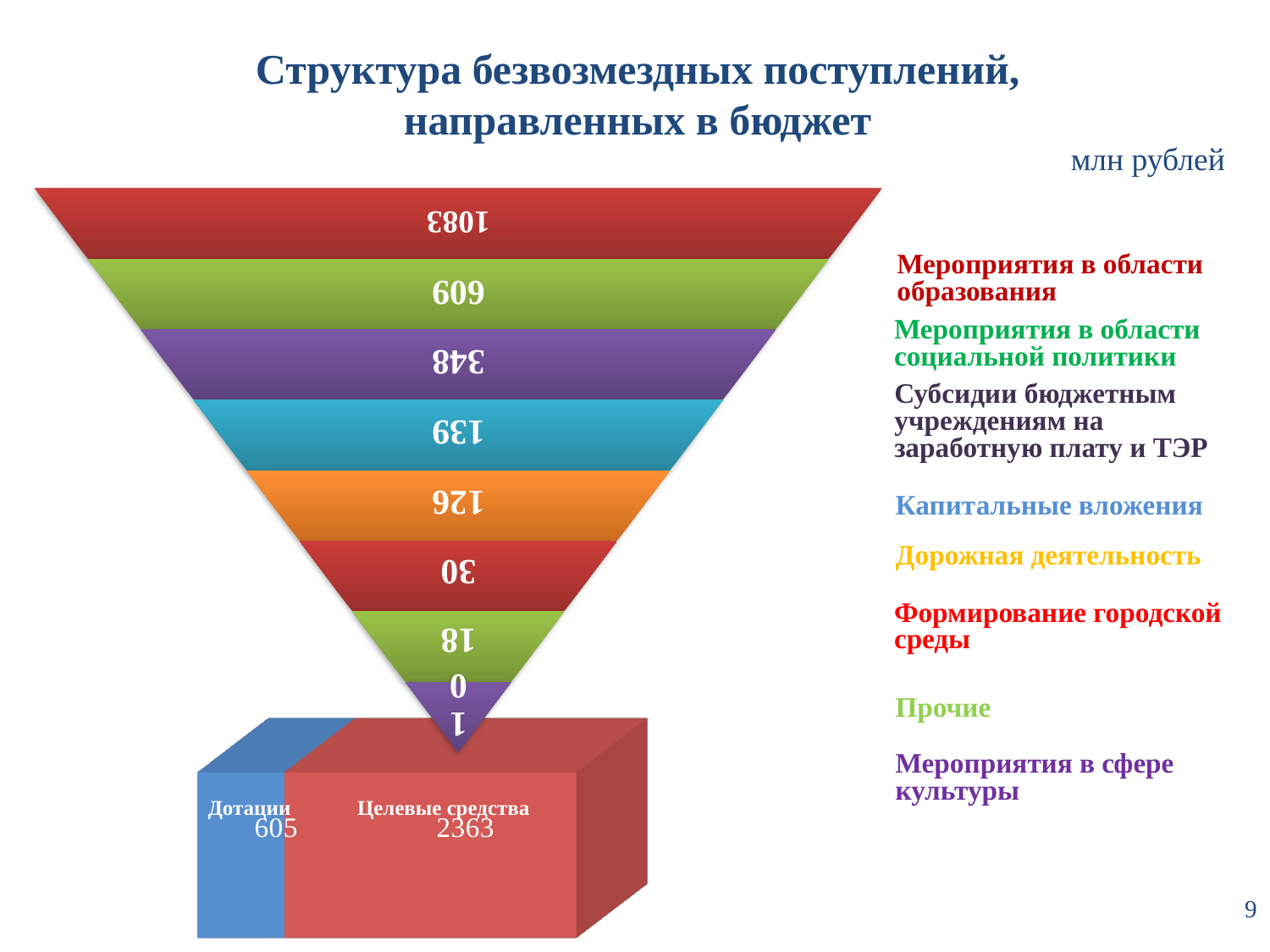
What is the total of Дотации and Целевые средства in the bar at the bottom of the slide? 2968 What is the value for Капитальные вложения in the funnel chart? 139 What is the value for Мероприятия в области социальной политики in the funnel chart? 609 In what units are the values on the slide given? млн рублей What is the difference between Мероприятия в области образования and Мероприятия в области социальной политики in the funnel chart? 474 Which is larger in the funnel chart: Капитальные вложения or Дорожная деятельность? Капитальные вложения In the bar at the bottom of the slide, what is the value for Целевые средства? 2363 Which category has the largest value in the funnel chart? Мероприятия в области образования In the bar at the bottom of the slide, what is the value for Дотации? 605 What is the value for Мероприятия в области образования in the funnel chart? 1083 What is the value for Дорожная деятельность in the funnel chart? 126 What is the value for Субсидии бюджетным учреждениям на заработную плату и ТЭР in the funnel chart? 348